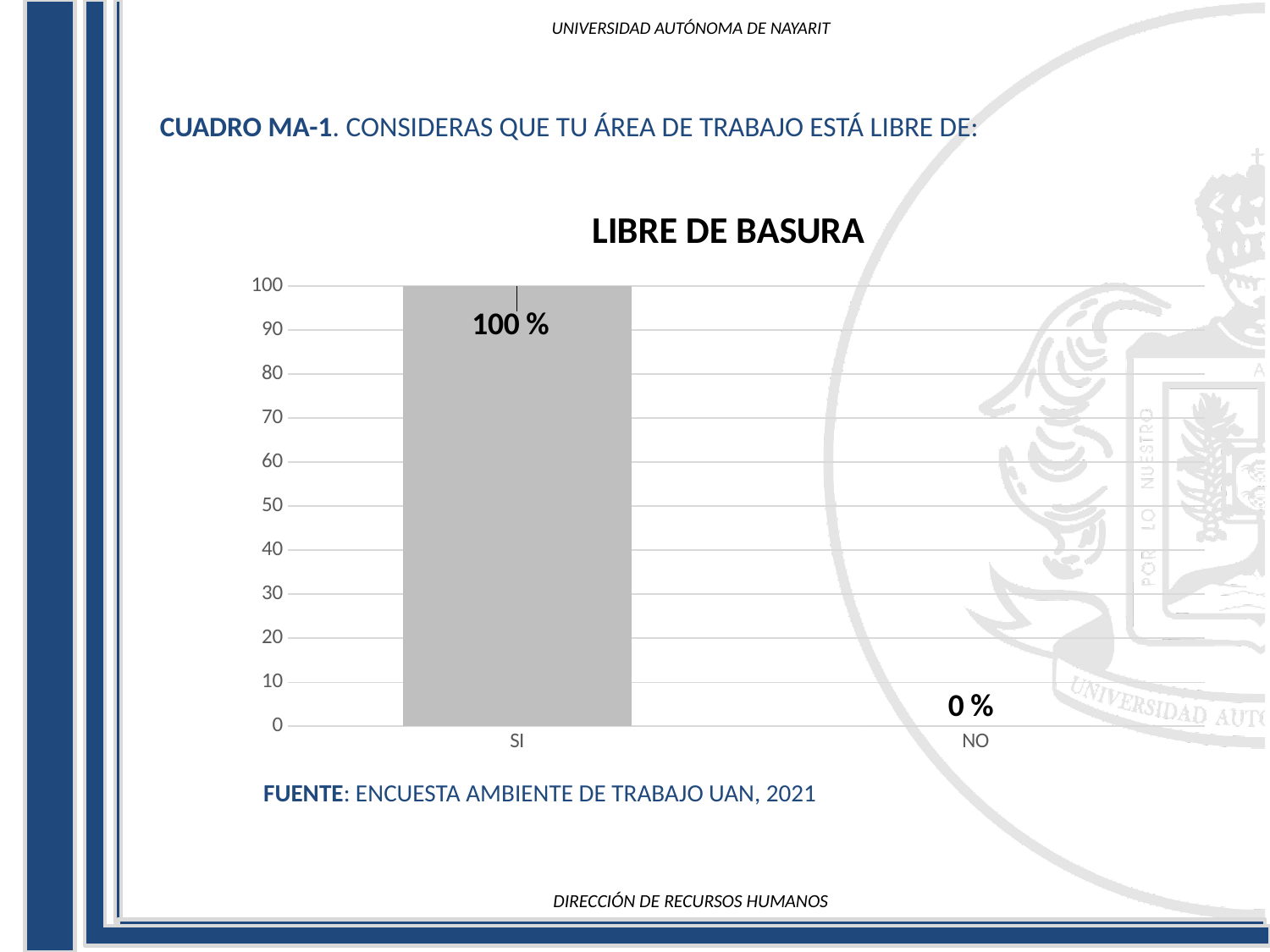
How many categories are shown on the x axis? 2 What is the value for NO? 0 % What is the highest value shown on the y axis? 100 Which is larger, the value for SI or the value for NO? SI Which category has the lowest value? NO What is the difference between the values for SI and NO? 100 % Is the value for SI greater or less than 50? greater What is the title of the chart? LIBRE DE BASURA Which category has the highest value? SI What kind of chart is shown? bar chart What is the value for SI? 100 %